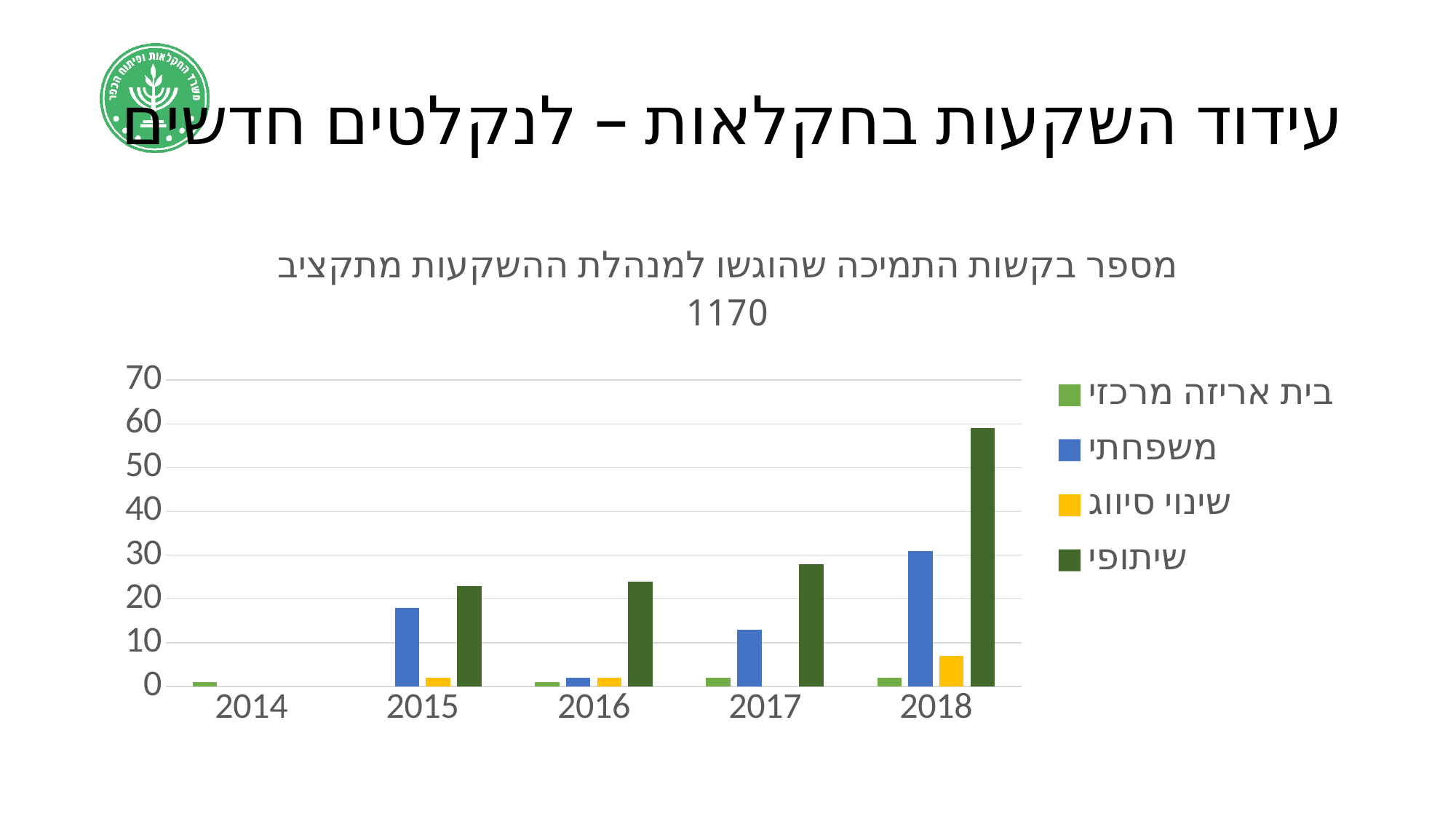
What kind of chart is shown on the slide? bar chart Do the שיתופי values rise or fall from 2015 to 2018? rise What colour represents the שיתופי series in the legend? dark green Is the value for משפחתי in 2018 greater or less than 20? greater Which series has the tallest bar in 2018? שיתופי How many years are shown on the x axis? 5 How many series does the legend list? 4 Is the value for שינוי סיווג in 2018 greater or less than 10? less Is the value for משפחתי in 2015 greater or less than 20? less In 2017, which is larger: משפחתי or שיתופי? שיתופי In which year is the שיתופי bar the highest? 2018